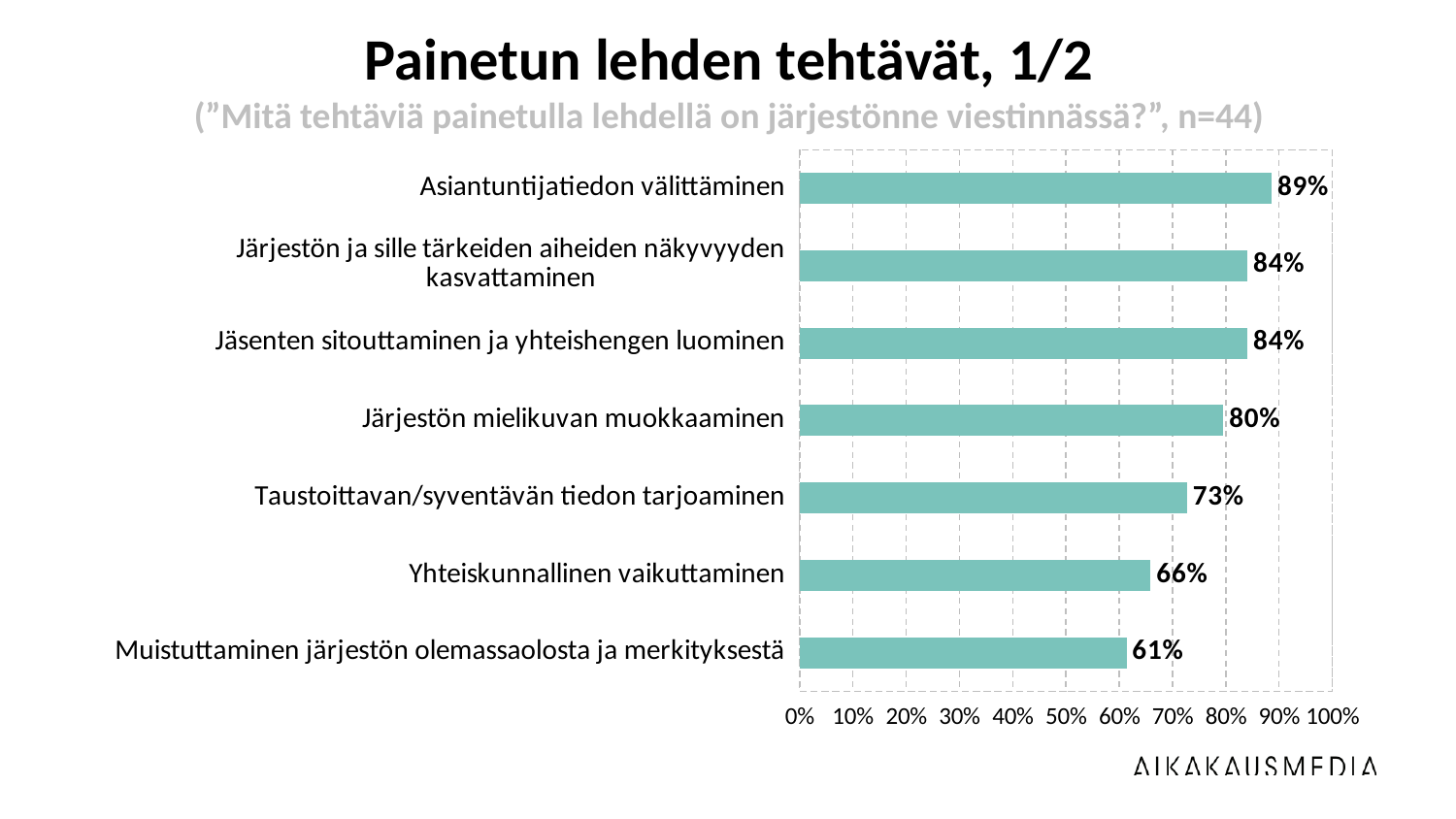
How many categories are shown in the chart? 7 What is the value for Asiantuntijatiedon välittäminen? 89% What is the value for Järjestön mielikuvan muokkaaminen? 80% Is the value for Taustoittavan/syventävän tiedon tarjoaminen greater or less than 70%? greater What is the title of the chart? Painetun lehden tehtävät, 1/2 Which category has the lowest value? Muistuttaminen järjestön olemassaolosta ja merkityksestä Which is larger, the value for Järjestön mielikuvan muokkaaminen or the value for Yhteiskunnallinen vaikuttaminen? Järjestön mielikuvan muokkaaminen What is the difference between the values for Asiantuntijatiedon välittäminen and Muistuttaminen järjestön olemassaolosta ja merkityksestä? 28% Which category has the highest value? Asiantuntijatiedon välittäminen What is the value for Taustoittavan/syventävän tiedon tarjoaminen? 73% What kind of chart is shown on the slide? bar chart What is the value for Yhteiskunnallinen vaikuttaminen? 66%